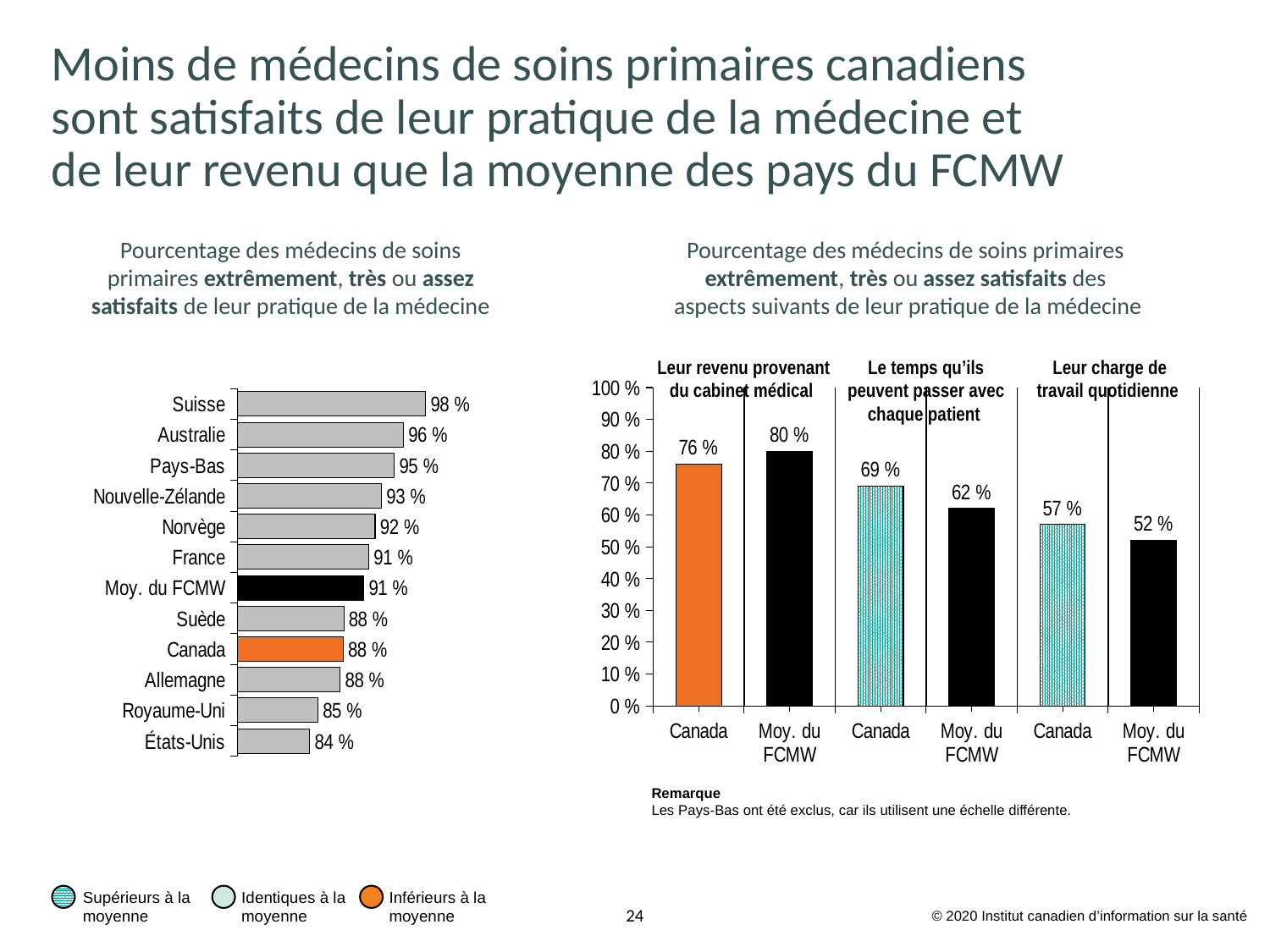
What type of chart is the left chart? Bar chart In the left chart, which country has the lowest value? États-Unis How many bars are shown in the left chart? 12 In the right chart, what is the value for Canada for 'Leur revenu provenant du cabinet médical'? 76 % In the left chart (satisfaction with their practice of medicine), what is the value for Canada? 88 % How many aspects (groups of bars) are shown in the right chart? 3 In the left chart, what colour is the bar for Canada? Orange In the right chart, for 'Le temps qu'ils peuvent passer avec chaque patient', which is larger: Canada or Moy. du FCMW? Canada In the left chart, what is the difference between the value for Suisse and the value for Canada? 10 % In the right chart, what is the difference between Canada and Moy. du FCMW for 'Leur charge de travail quotidienne'? 5 % In the left chart, which country has the highest percentage of primary care physicians satisfied with their practice of medicine? Suisse In the right chart, what is the value for Moy. du FCMW for 'Leur revenu provenant du cabinet médical'? 80 %